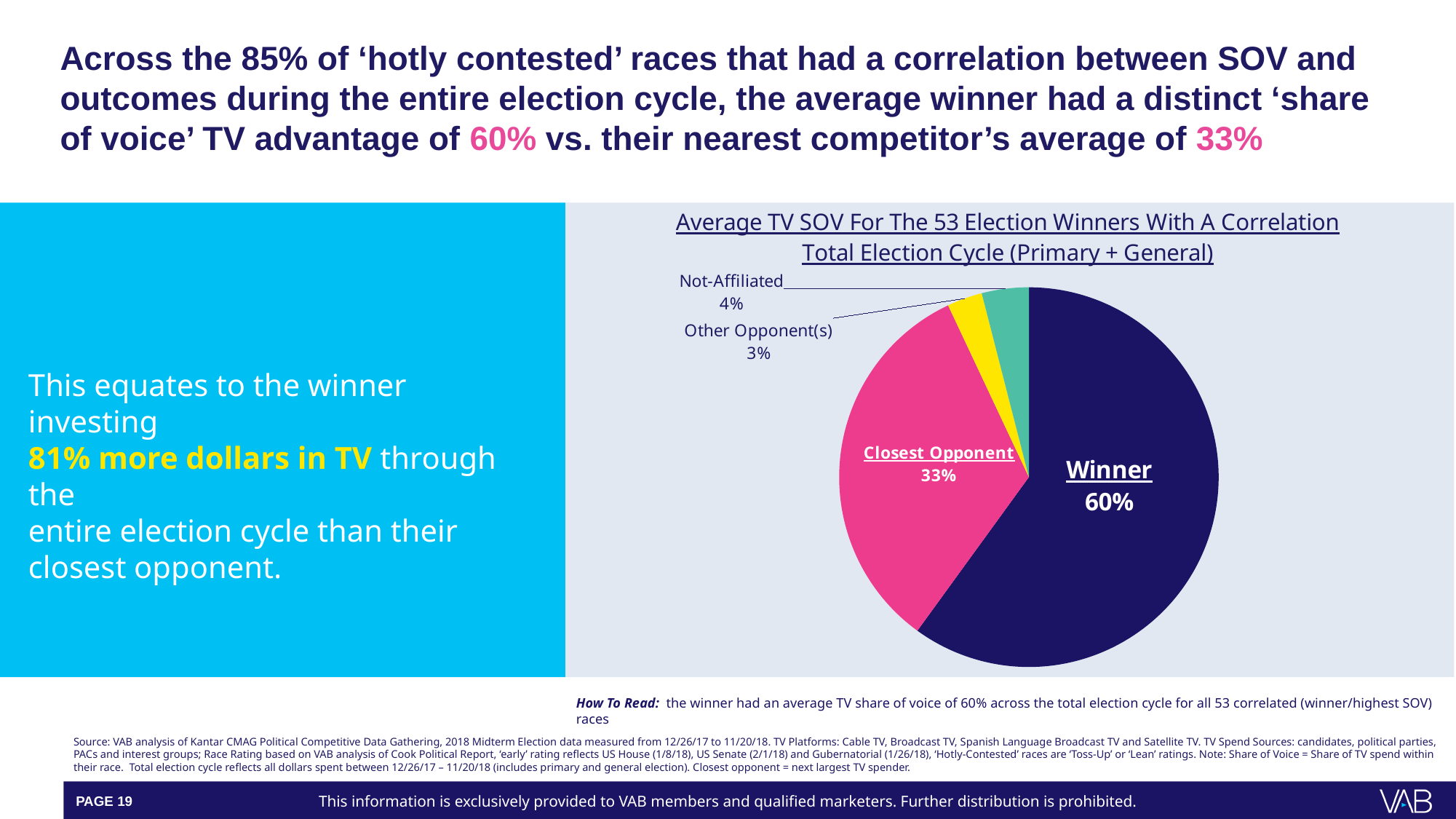
What is the difference in percentage points between the Winner and the Closest Opponent? 27 Which is larger, the Not-Affiliated share or the Other Opponent(s) share? Not-Affiliated What is the title of the pie chart? Average TV SOV For The 53 Election Winners With A Correlation Total Election Cycle (Primary + General) What is the average TV SOV for the Winner? 60% What is the share for Not-Affiliated? 4% What colour is the Closest Opponent slice? pink Which slice of the pie is the largest? Winner What is the average TV SOV for the Closest Opponent? 33% How many slices does the pie chart have? 4 What is the share for Other Opponent(s)? 3% Which slice of the pie is the smallest? Other Opponent(s) What kind of chart is shown on the slide? pie chart